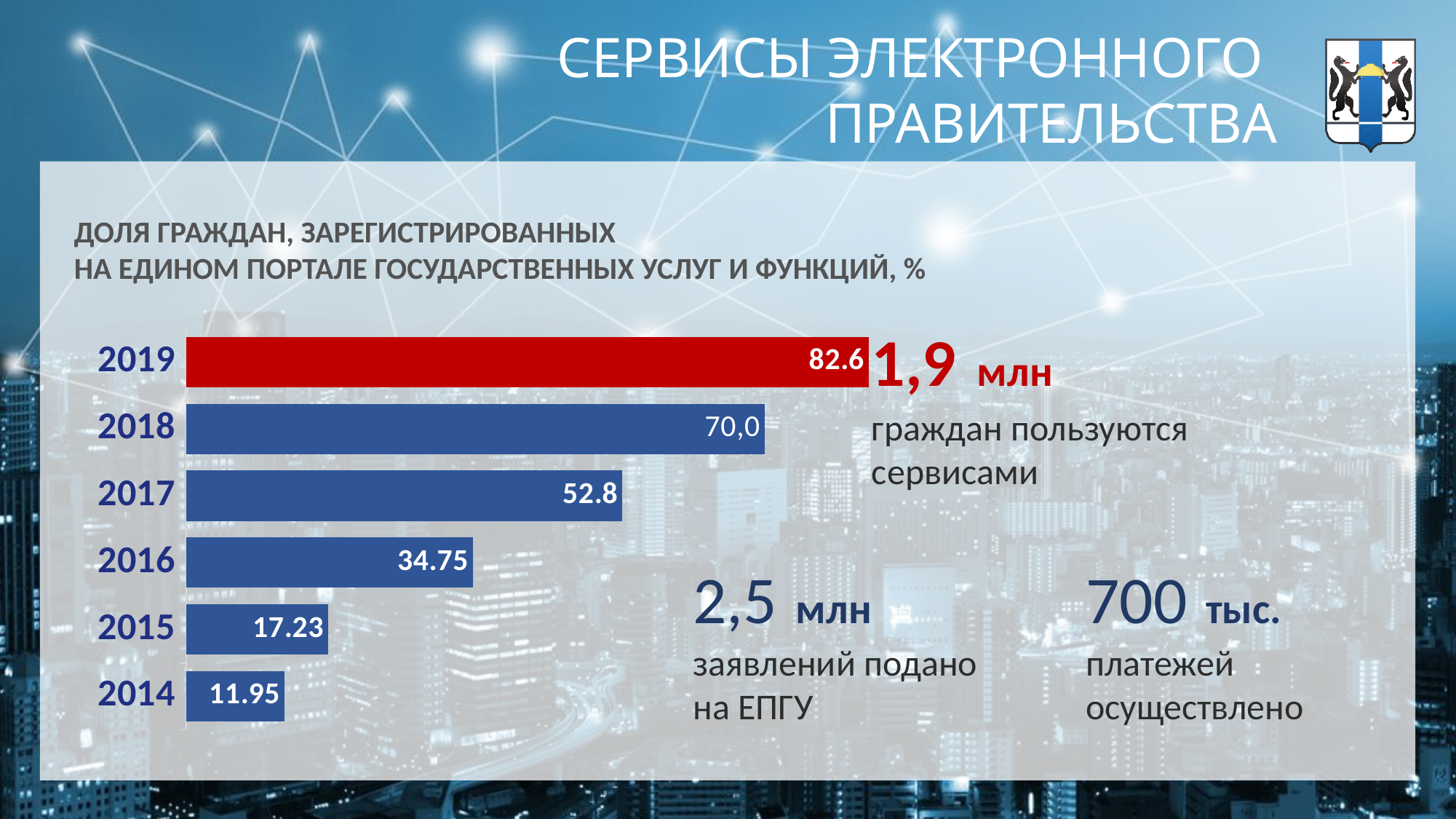
What is the difference between the values for 2017 and 2016? 18.05 What type of chart is shown on the slide? bar chart Which is larger, the value for 2017 or the value for 2016? 2017 What is the difference between the values for 2015 and 2014? 5.28 Which year has the lowest value in the bar chart? 2014 What is the value for 2019 in the chart of the share of citizens registered on the unified portal of state services? 82.6 Do the values in the chart rise or fall from 2014 to 2019? rise How many years are shown in the bar chart? 6 What value is shown for 2014 in the bar chart? 11.95 What value is labelled on the 2018 bar? 70,0 Which year has the highest value in the bar chart? 2019 What value is shown for 2016 in the bar chart? 34.75